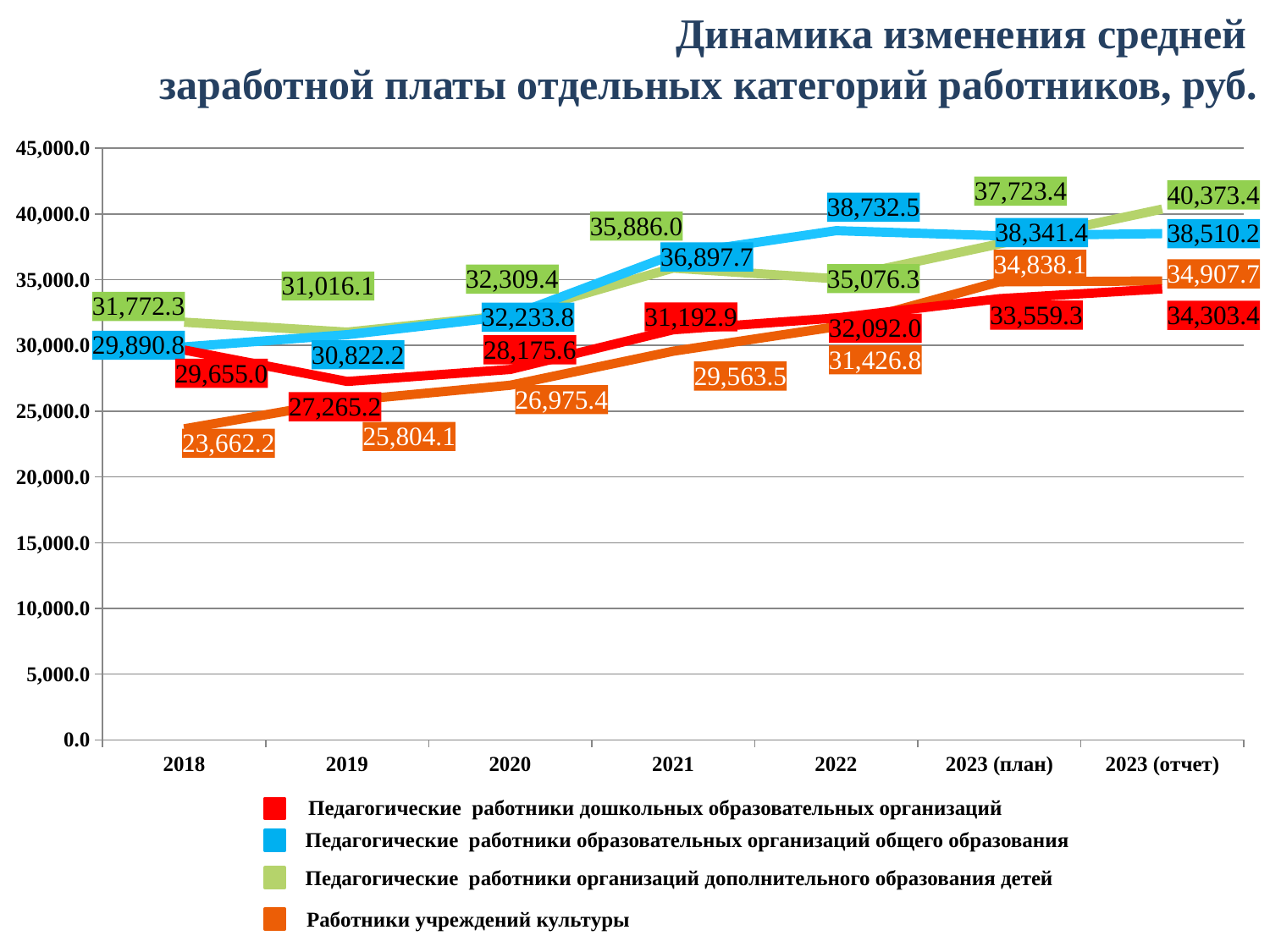
In 2023 (отчет), which is larger: the value for Педагогические работники дошкольных образовательных организаций or for Работники учреждений культуры? Работники учреждений культуры What is the difference between the 2023 (отчет) and 2018 values for Педагогические работники дошкольных образовательных организаций? 4,648.4 Is the 2018 value for Работники учреждений культуры greater or less than 25,000.0? less What kind of chart is shown on the slide? line chart By how much did the value for Педагогические работники образовательных организаций общего образования change from 2021 to 2022? 1,834.8 In which year does the series Педагогические работники организаций дополнительного образования детей reach its highest value? 2023 (отчет) How many series does the legend list? 4 How many points are shown on the x axis? 7 In which year is the value for Работники учреждений культуры lowest? 2018 What is the value for Педагогические работники образовательных организаций общего образования in 2022? 38,732.5 What is the value for Работники учреждений культуры in 2018? 23,662.2 What is the value for Педагогические работники организаций дополнительного образования детей in 2023 (отчет)? 40,373.4